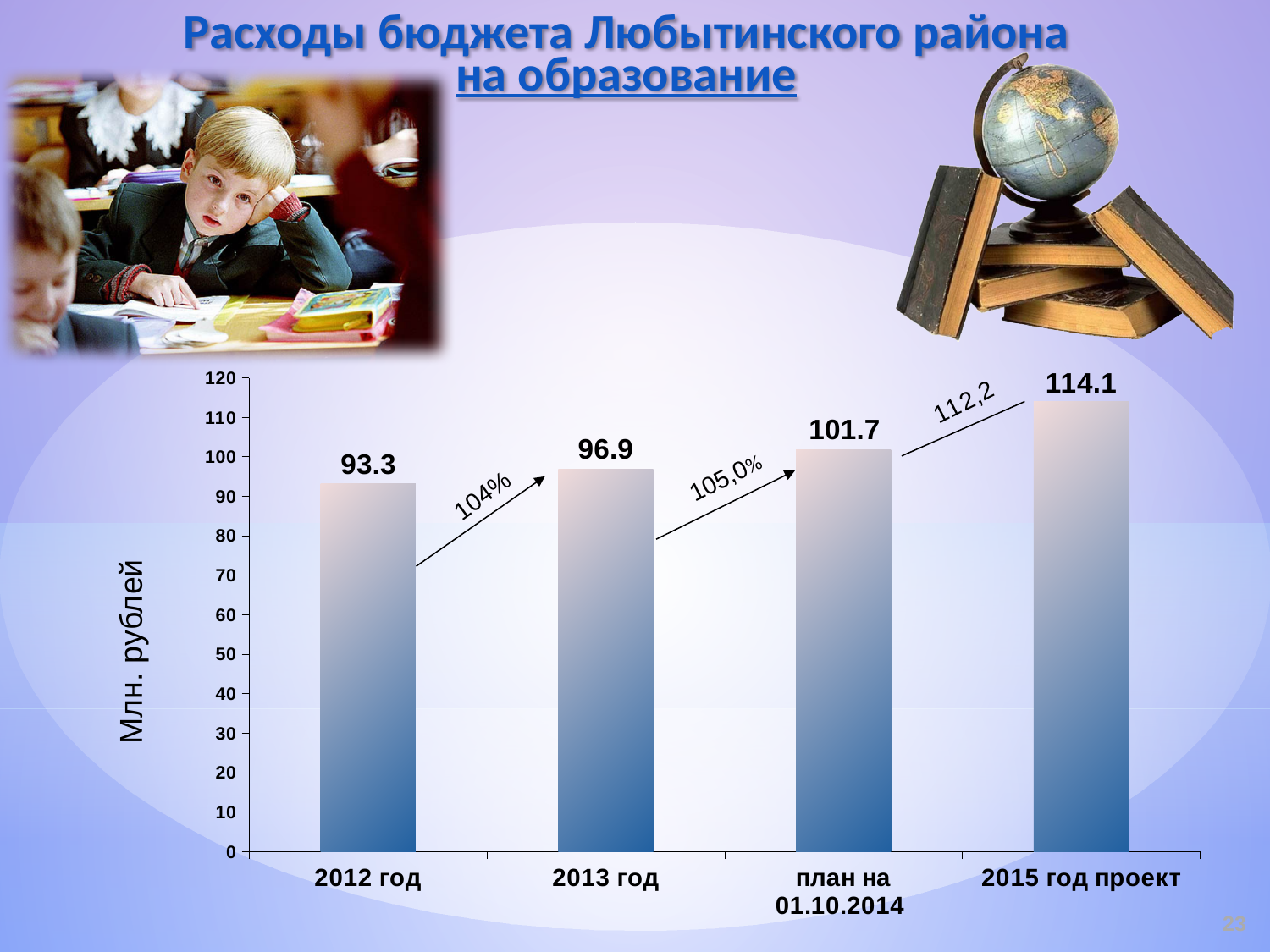
Do the values rise or fall from 2012 год to 2015 год проект? rise What is the difference between the values for 2015 год проект and план на 01.10.2014? 12.4 What is the label of the vertical axis? Млн. рублей What is the value for план на 01.10.2014? 101.7 Which category has the lowest value? 2012 год What is the value for 2015 год проект? 114.1 How many categories are shown on the x axis? 4 What is the value for 2013 год? 96.9 What is the value for 2012 год? 93.3 Which is larger, the value for 2013 год or the value for 2012 год? 2013 год Which category has the highest value? 2015 год проект What kind of chart is shown on the slide? bar chart